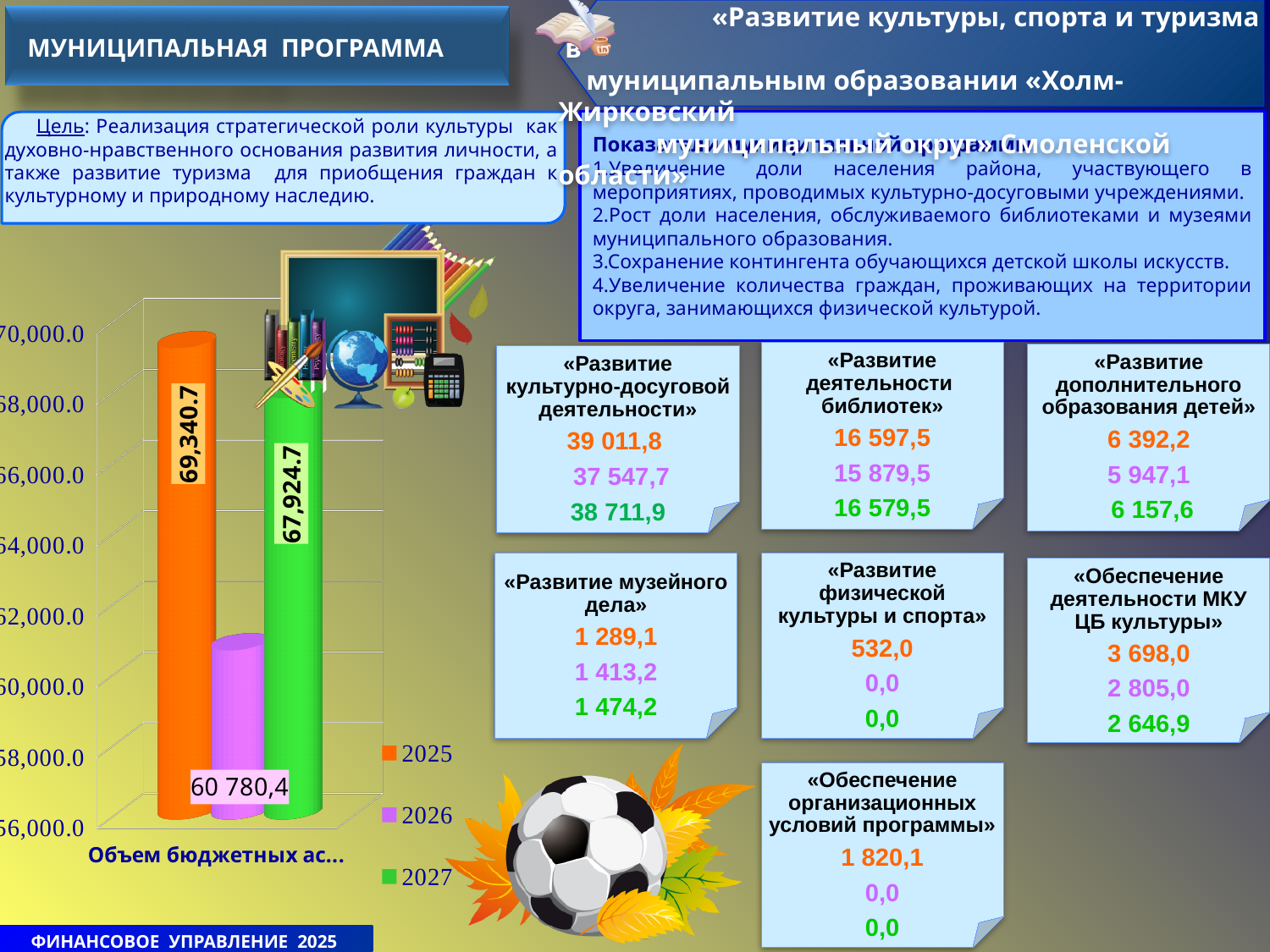
What is the difference between the 2025 and 2027 values in the chart? 1,416.0 Which is larger in the chart, the 2026 value or the 2027 value? 2027 What is the value of the 2026 bar in the chart? 60 780,4 What is the value of the 2027 bar in the chart? 67,924.7 What colour is the 2026 series in the chart legend? purple Is the value for 2026 greater or less than 62,000.0? less What kind of chart is shown on the slide? bar chart What is the difference between the 2027 and 2026 values in the chart? 7,144.3 Which year has the lowest bar in the chart? 2026 Which year has the highest bar in the chart? 2025 What is the value of the 2025 bar in the chart? 69,340.7 How many series does the chart legend list? 3